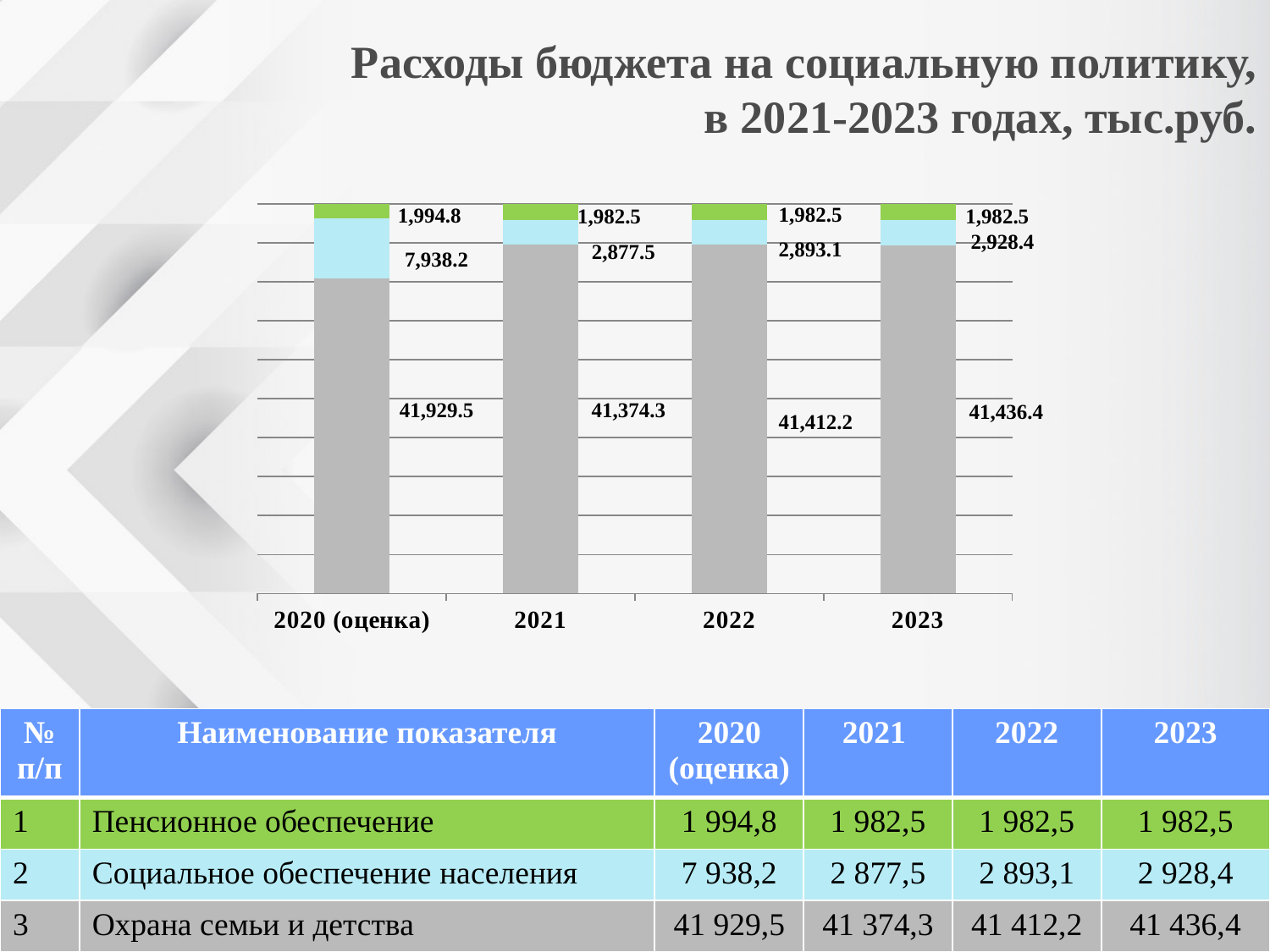
Does the grey (bottom) segment rise or fall from 2021 to 2023? Rises In which year is the grey (bottom) segment the smallest? 2021 What is the title of the chart on the slide? Расходы бюджета на социальную политику, в 2021-2023 годах, тыс.руб. How many years (categories) are shown on the x axis of the chart? 4 What is the value of the light blue (middle) segment for 2020 (оценка)? 7,938.2 What is the value of the green (top) segment for 2023? 1,982.5 What is the total of the stacked bar for 2021? 46,234.3 Which is larger: the light blue segment for 2022 or for 2023? 2023 In which year is the light blue (middle) segment the largest? 2020 (оценка) What type of chart is shown on the slide? Stacked bar chart What is the difference between the grey segment values for 2020 (оценка) and 2021? 555.2 What is the value of the grey (bottom) segment for 2021? 41,374.3